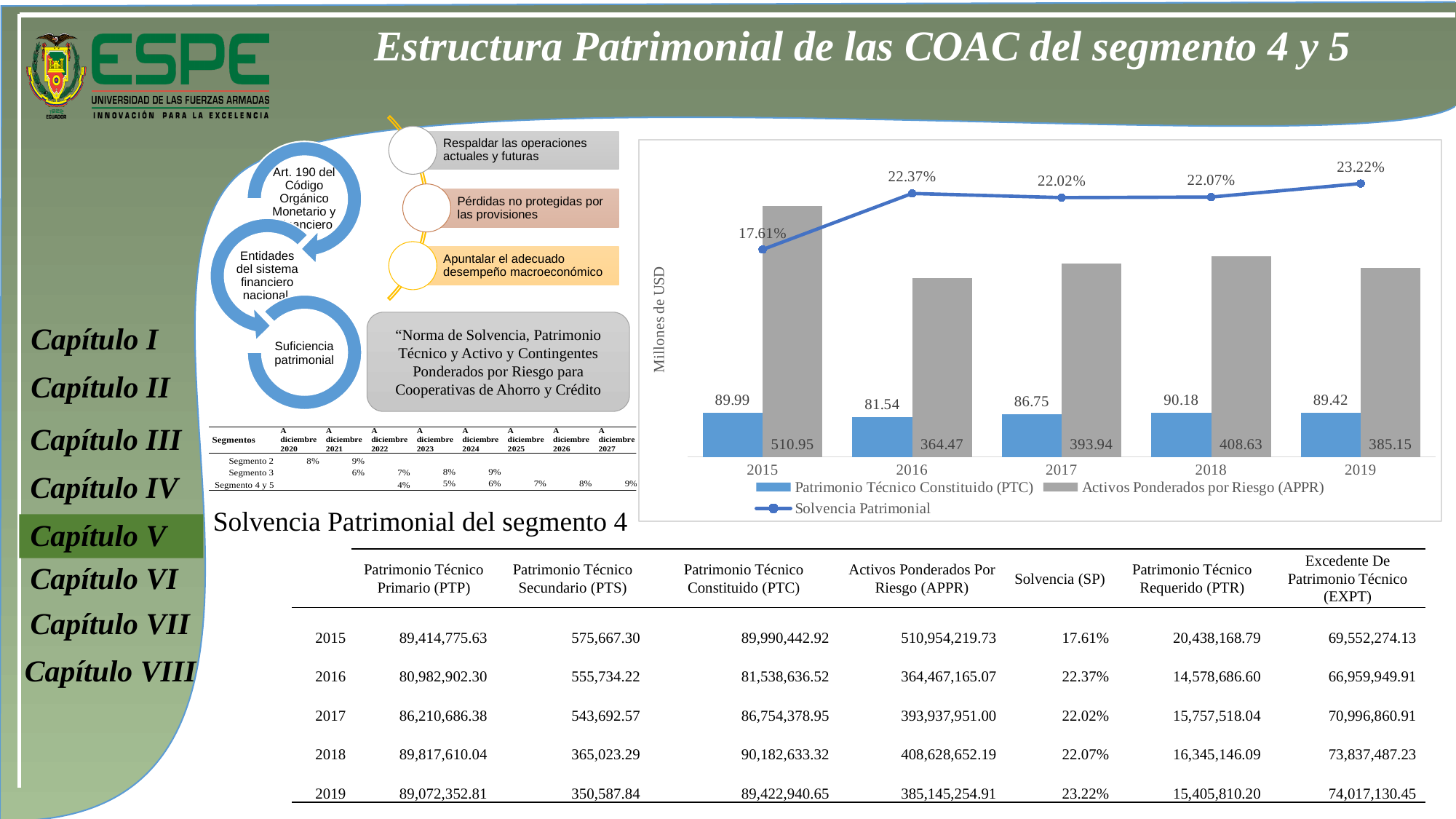
In which year is Solvencia Patrimonial lowest in the chart? 2015 What kind of chart is shown on the slide? Combined bar and line chart What is the label on the vertical axis of the chart? Millones de USD How many series does the chart's legend list? 3 In which year is Activos Ponderados por Riesgo (APPR) highest in the chart? 2015 What is the value of Activos Ponderados por Riesgo (APPR) for 2015 in the chart? 510.95 What is the Solvencia Patrimonial value for 2019 in the chart? 23.22% In which year is Patrimonio Técnico Constituido (PTC) lowest in the chart? 2016 Which is larger in the chart: the APPR value for 2017 or for 2018? 2018 How many years are shown on the x axis of the chart? 5 What is the value of Patrimonio Técnico Constituido (PTC) for 2018 in the chart? 90.18 What is the difference between the APPR values for 2015 and 2016 in the chart? 146.48